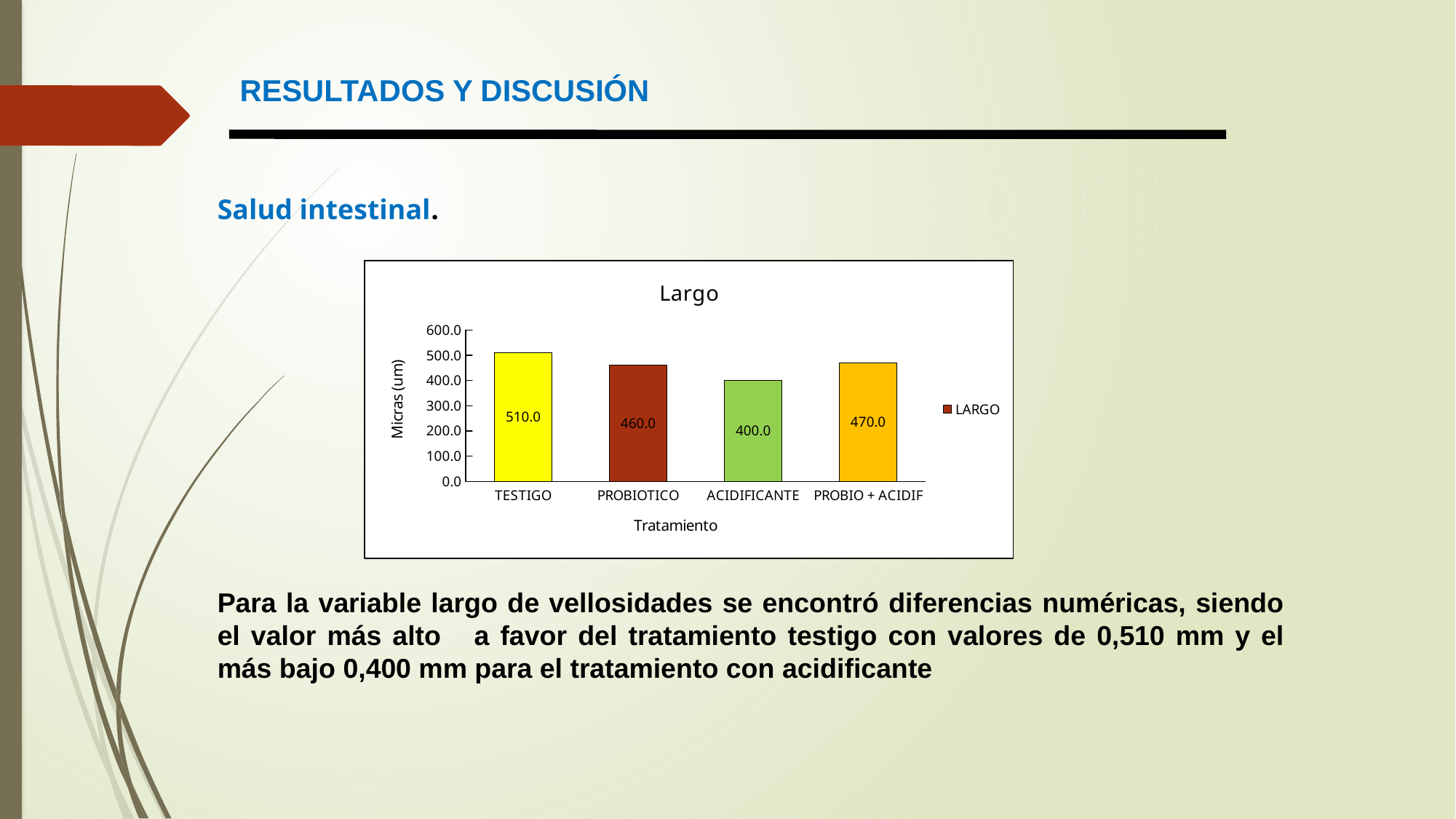
What is the value for ACIDIFICANTE in the Largo chart? 400.0 What kind of chart is shown on the slide? bar chart Is the value for PROBIOTICO greater or less than 500.0? less Which treatment has the lowest value in the Largo chart? ACIDIFICANTE Which treatment has the highest value in the Largo chart? TESTIGO How many treatments are shown on the x axis of the chart? 4 What is the value for PROBIOTICO in the Largo chart? 460.0 What is the difference between the values for TESTIGO and ACIDIFICANTE? 110.0 What is the value for TESTIGO in the Largo chart? 510.0 Which is larger, the value for PROBIOTICO or the value for PROBIO + ACIDIF? PROBIO + ACIDIF What is the value for PROBIO + ACIDIF in the Largo chart? 470.0 What is the label on the y axis of the chart? Micras (um)